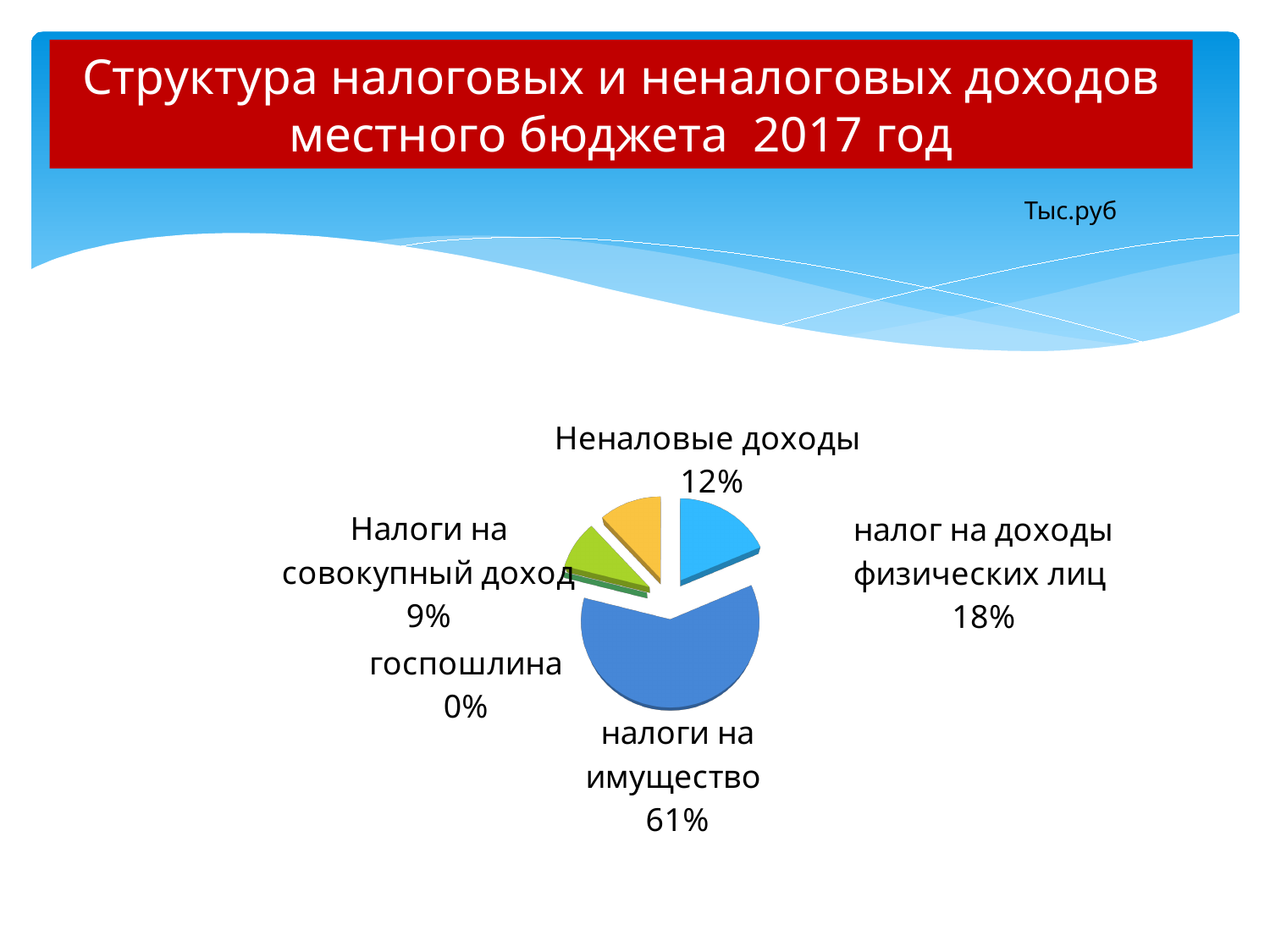
What kind of chart is shown on the slide? pie chart What share of the pie does "налог на доходы физических лиц" have? 18% What share of the pie does "Налоги на совокупный доход" have? 9% How many slices (categories) does the pie chart have? 5 What share of the pie does "госпошлина" have? 0% What is the difference in percentage points between "налоги на имущество" and "налог на доходы физических лиц"? 43% What unit is indicated on the slide above the chart? Тыс.руб Which category has the largest share of the pie? налоги на имущество Which is larger: the share for "налог на доходы физических лиц" or the share for "Неналовые доходы"? налог на доходы физических лиц Which category has the smallest share of the pie? госпошлина